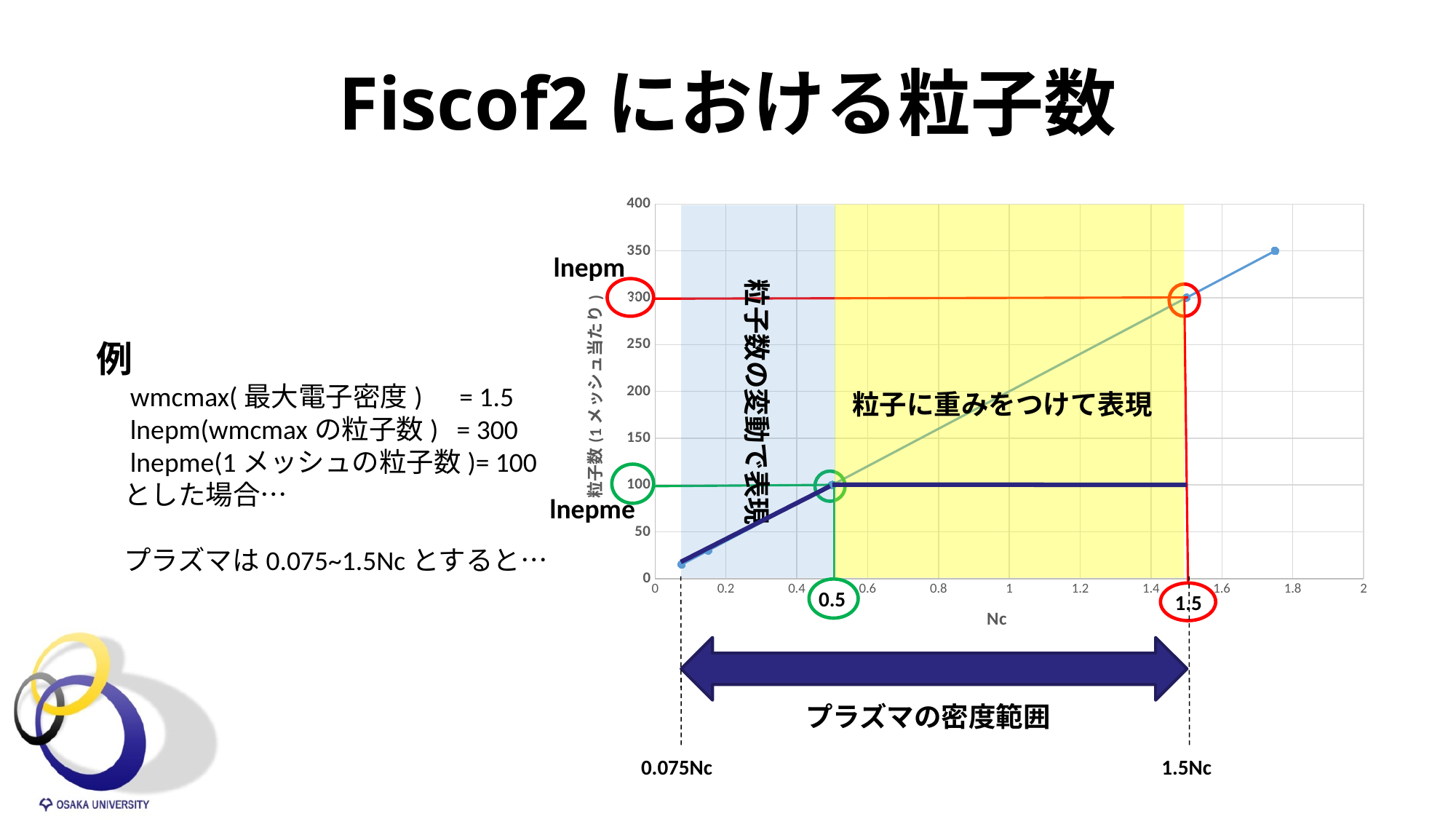
What is the value of 粒子数 (1メッシュ当たり) at Nc = 0.5 (lnepme)? 100 Do the plotted values rise or fall as Nc increases? rise What is the title of the x axis of the chart? Nc What is the maximum value shown on the y axis of the chart? 400 What kind of chart is shown on the slide? line chart What is the value of 粒子数 (1メッシュ当たり) at Nc = 1.5 (lnepm)? 300 Which has the larger particle count, Nc = 1.5 or Nc = 0.5? Nc = 1.5 Is the particle count at Nc = 0.075 greater or less than 50? less Is the particle count at Nc = 1.75 greater or less than 300? greater What is the difference between the particle count at Nc = 1.5 and at Nc = 0.5? 200